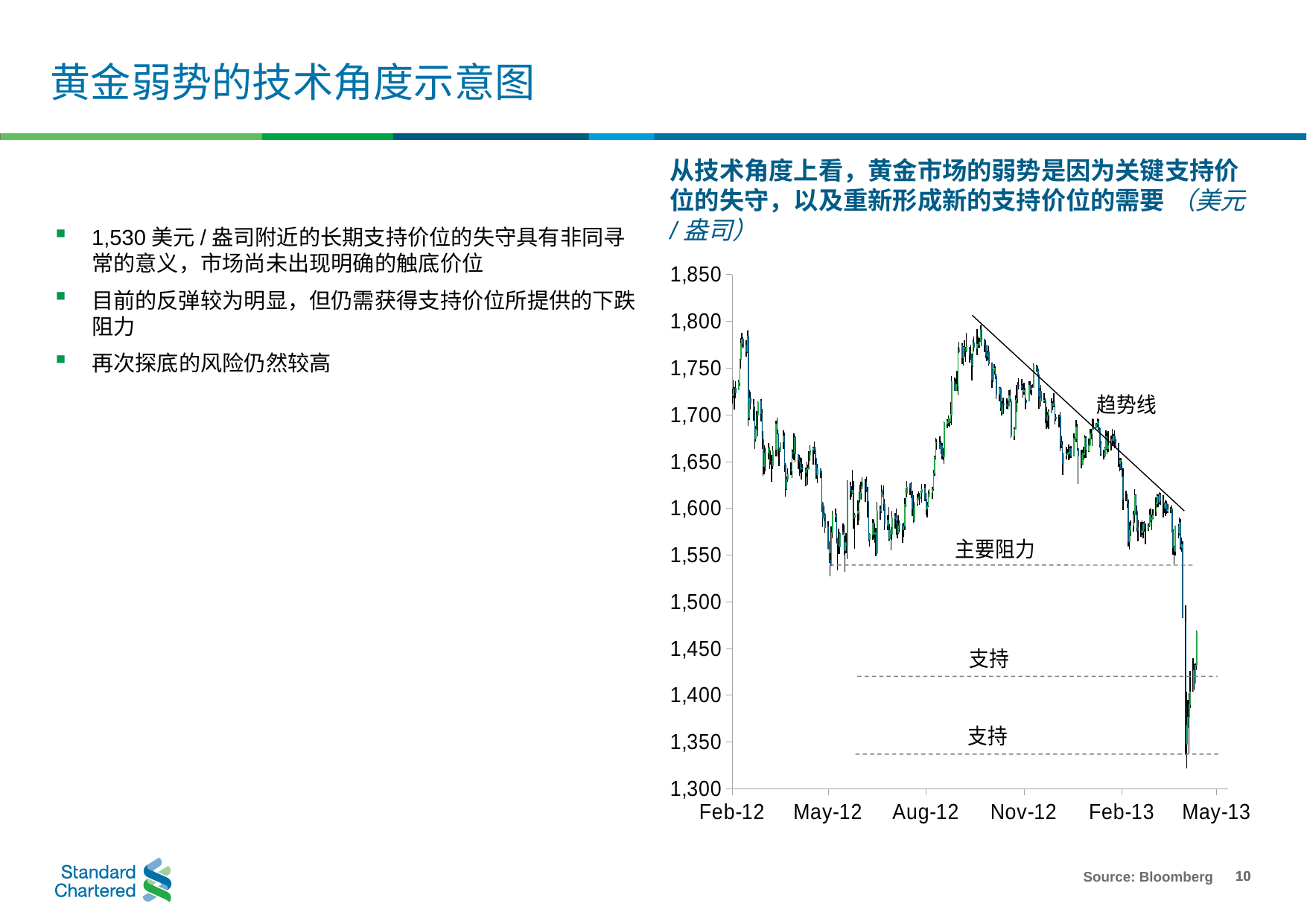
Is the lowest point of the gold price on the chart greater or less than 1,350? less Overall, does the gold price rise or fall from Feb-12 to May-13? fall How many date labels are shown on the x axis? 6 What kind of chart is shown on the slide? stock (candlestick) chart Is the highest point of the gold price on the chart greater or less than 1,750? greater Is the gold price higher at Feb-12 or at May-13? Feb-12 What is the source cited for the chart? Bloomberg What is the highest value shown on the y axis? 1,850 Is the gold price at the end of the chart (May-13) greater or less than 1,500? less